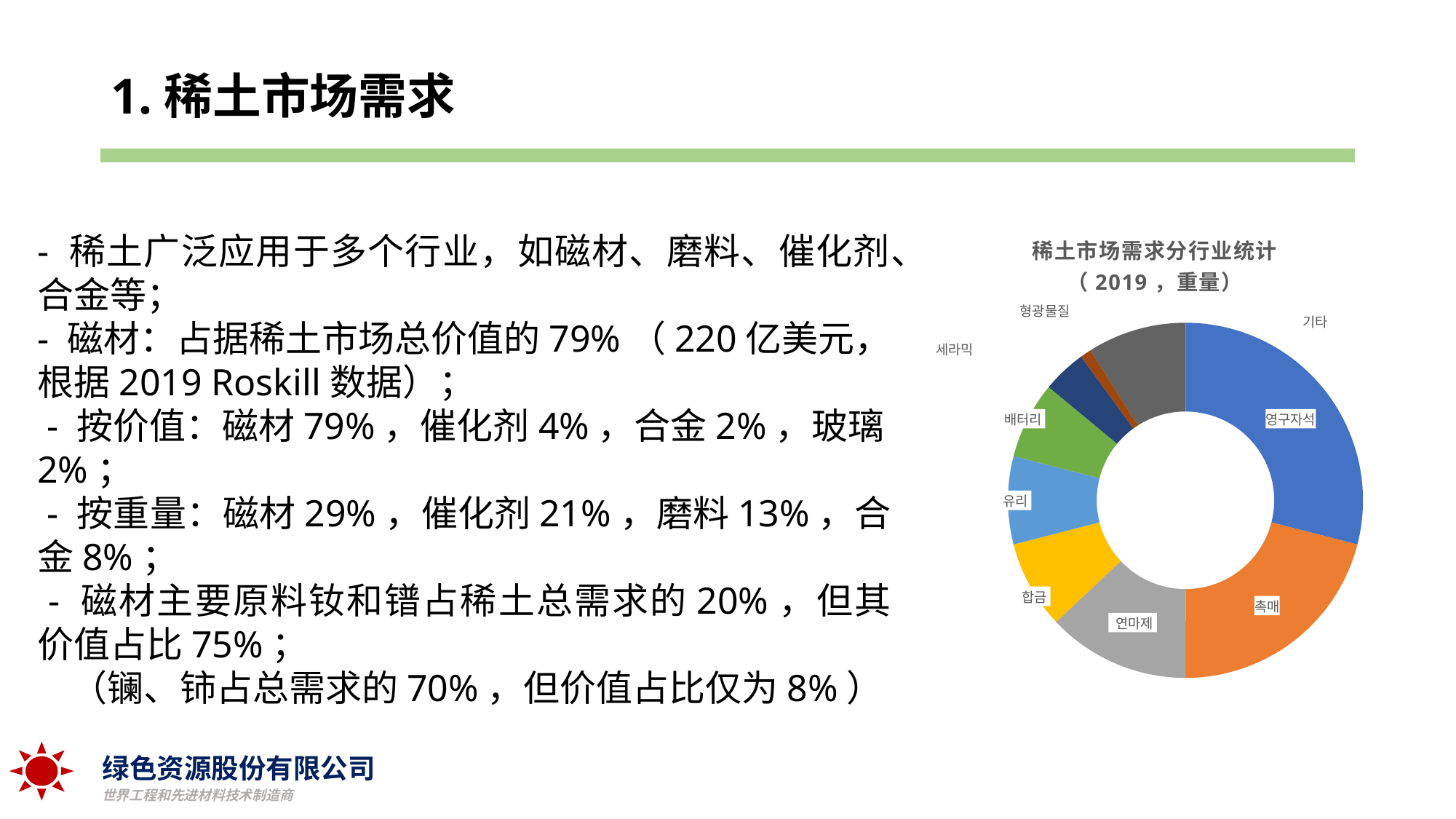
What colour is the 영구자석 slice? Blue Which category has the smallest slice in the chart? 형광물질 What kind of chart is shown on the slide? Doughnut (pie) chart Which category has the largest slice in the chart? 영구자석 Which slice is larger, 영구자석 or 촉매? 영구자석 Which slice is larger, 촉매 or 연마제? 촉매 Which slice is larger, 기타 or 세라믹? 기타 How many categories (slices) does the chart show? 9 What is the title of the chart? 稀土市场需求分行业统计（2019，重量）